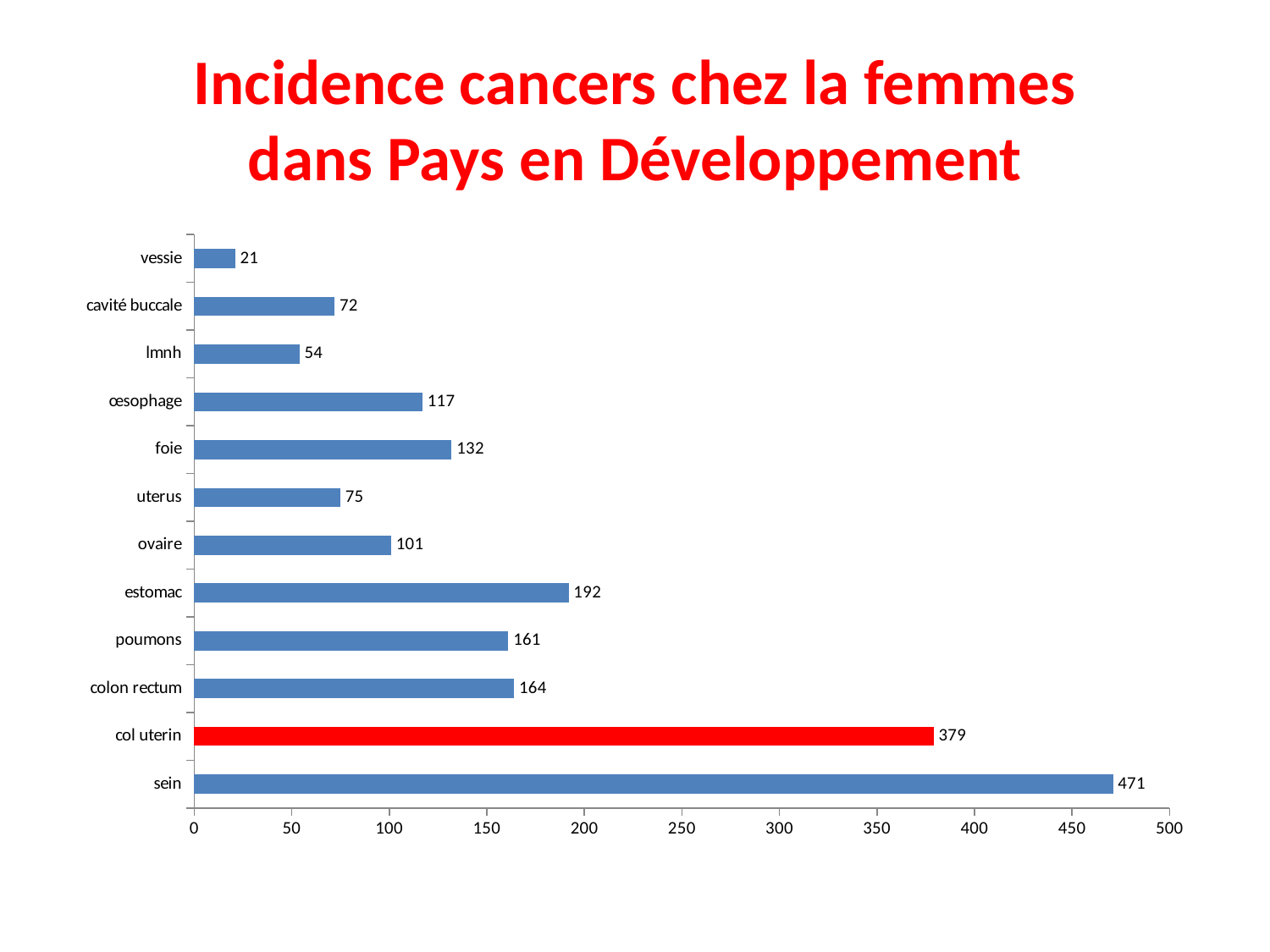
What kind of chart is shown on the slide? bar chart Which is larger, the value for foie or the value for œsophage? foie Which bar is coloured red instead of blue? col uterin What is the difference between the values for sein and col uterin? 92 Is the value for poumons greater or less than 150? greater What is the value for sein? 471 Which category has the highest value? sein Which category has the lowest value? vessie What is the value for col uterin? 379 What is the value for estomac? 192 What is the value for vessie? 21 How many categories are shown in the chart? 12